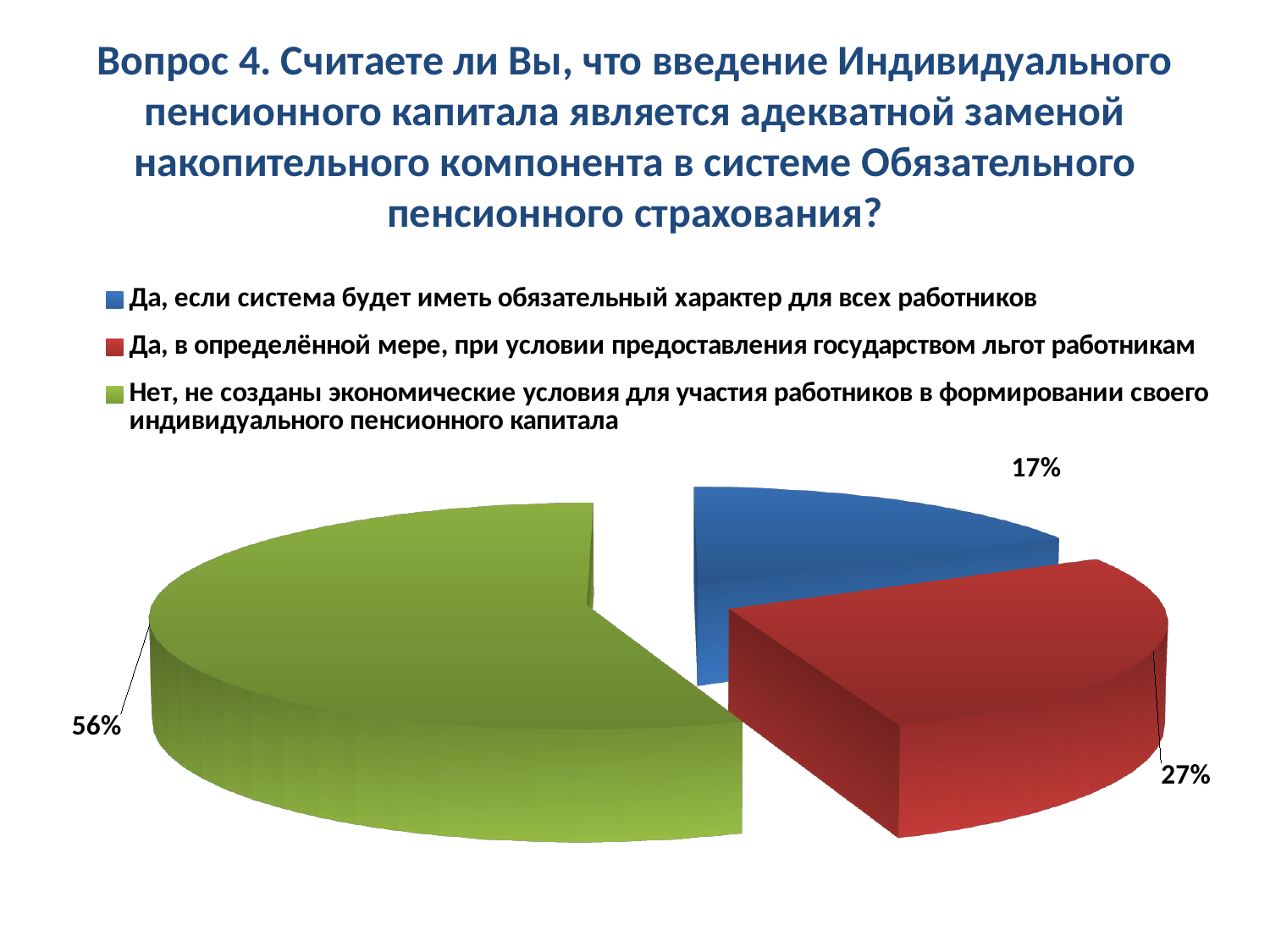
What colour is the slice representing 17%? blue What share of the pie is labelled for the answer "Нет, не созданы экономические условия для участия работников в формировании своего индивидуального пенсионного капитала"? 56% What kind of chart is shown on the slide? pie chart Which answer option has the largest share of the pie? Нет, не созданы экономические условия для участия работников в формировании своего индивидуального пенсионного капитала How many slices does the pie chart have? 3 What colour is the slice representing 56%? green Which answer option has the smallest share of the pie? Да, если система будет иметь обязательный характер для всех работников What share of the pie is labelled for the answer "Да, если система будет иметь обязательный характер для всех работников"? 17% What is the difference in percentage points between the green slice (56%) and the red slice (27%)? 29 How many entries does the legend list? 3 Which is larger: the share for "Да, в определённой мере..." or the share for "Да, если система будет иметь обязательный характер..."? Да, в определённой мере, при условии предоставления государством льгот работникам What share of the pie is labelled for the answer "Да, в определённой мере, при условии предоставления государством льгот работникам"? 27%